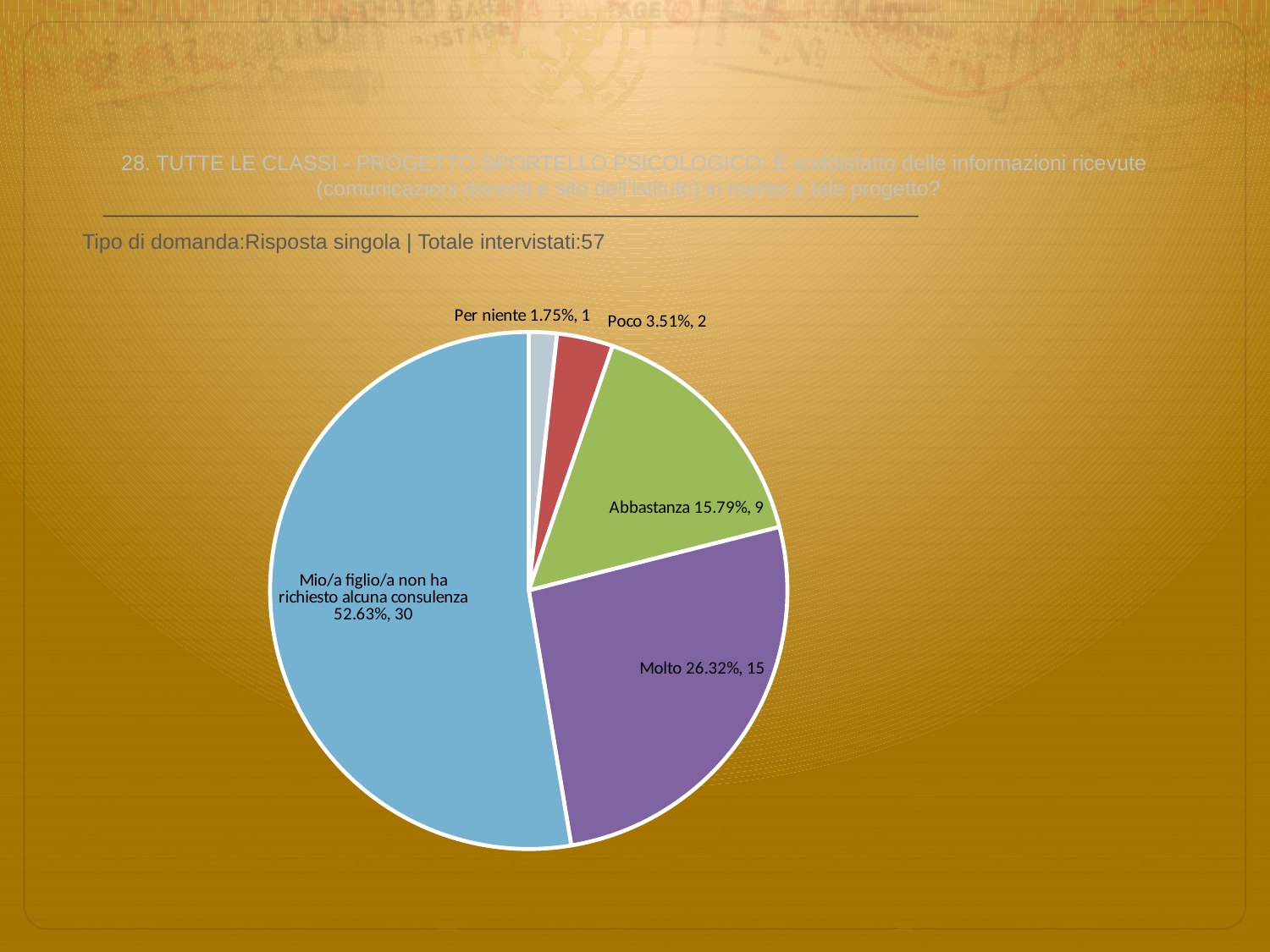
Which slice is the smallest in the pie chart? Per niente What is the total number of respondents stated on the slide? 57 What kind of chart is shown on the slide? pie chart How many respondents chose "Abbastanza"? 9 What percentage is shown for "Poco"? 3.51% Which has more respondents, "Poco" or "Abbastanza"? Abbastanza What percentage is shown for the "Molto" slice? 26.32% How many slices does the pie chart have? 5 Which slice is the largest in the pie chart? Mio/a figlio/a non ha richiesto alcuna consulenza What is the difference in count between "Molto" and "Abbastanza"? 6 What share of the pie does "Mio/a figlio/a non ha richiesto alcuna consulenza" represent? 52.63% How many respondents chose "Per niente"? 1